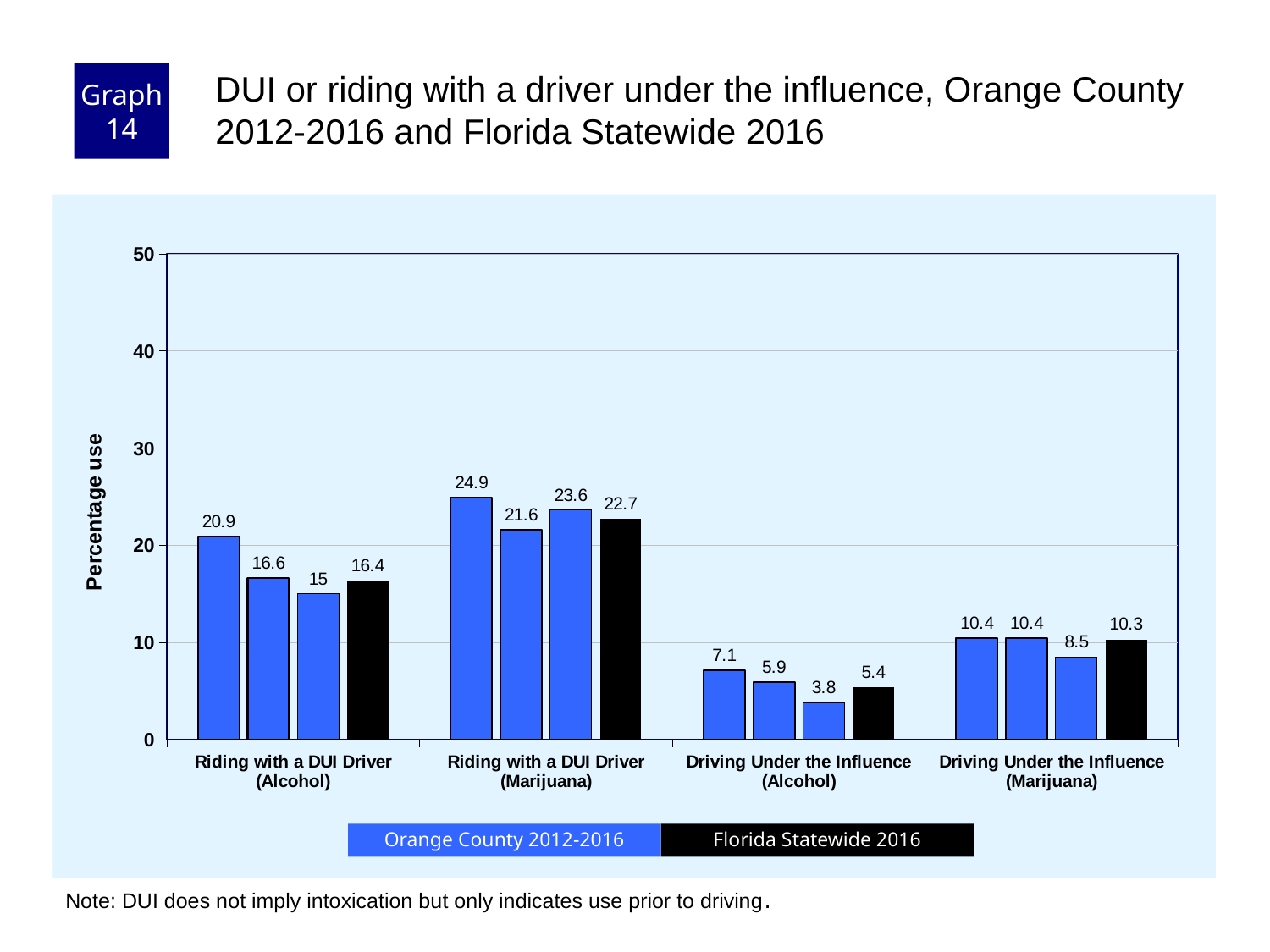
Which category has the lowest Florida Statewide 2016 value? Driving Under the Influence (Alcohol) How many series does the legend list? 2 What kind of chart is shown on the slide? bar chart What is the label on the y axis? Percentage use What is the Florida Statewide 2016 value for Driving Under the Influence (Alcohol)? 5.4 What is the Florida Statewide 2016 value for Riding with a DUI Driver (Marijuana)? 22.7 What is the value of the first (leftmost) Orange County bar for Riding with a DUI Driver (Alcohol)? 20.9 Which category has the highest Florida Statewide 2016 value? Riding with a DUI Driver (Marijuana) How many categories are shown along the x axis? 4 Is the Florida Statewide 2016 value for Riding with a DUI Driver (Alcohol) larger or smaller than the Florida Statewide 2016 value for Driving Under the Influence (Marijuana)? larger What is the difference between the first Orange County bar (24.9) and the Florida Statewide 2016 bar (22.7) for Riding with a DUI Driver (Marijuana)? 2.2 What is the value of the third Orange County bar for Driving Under the Influence (Marijuana)? 8.5